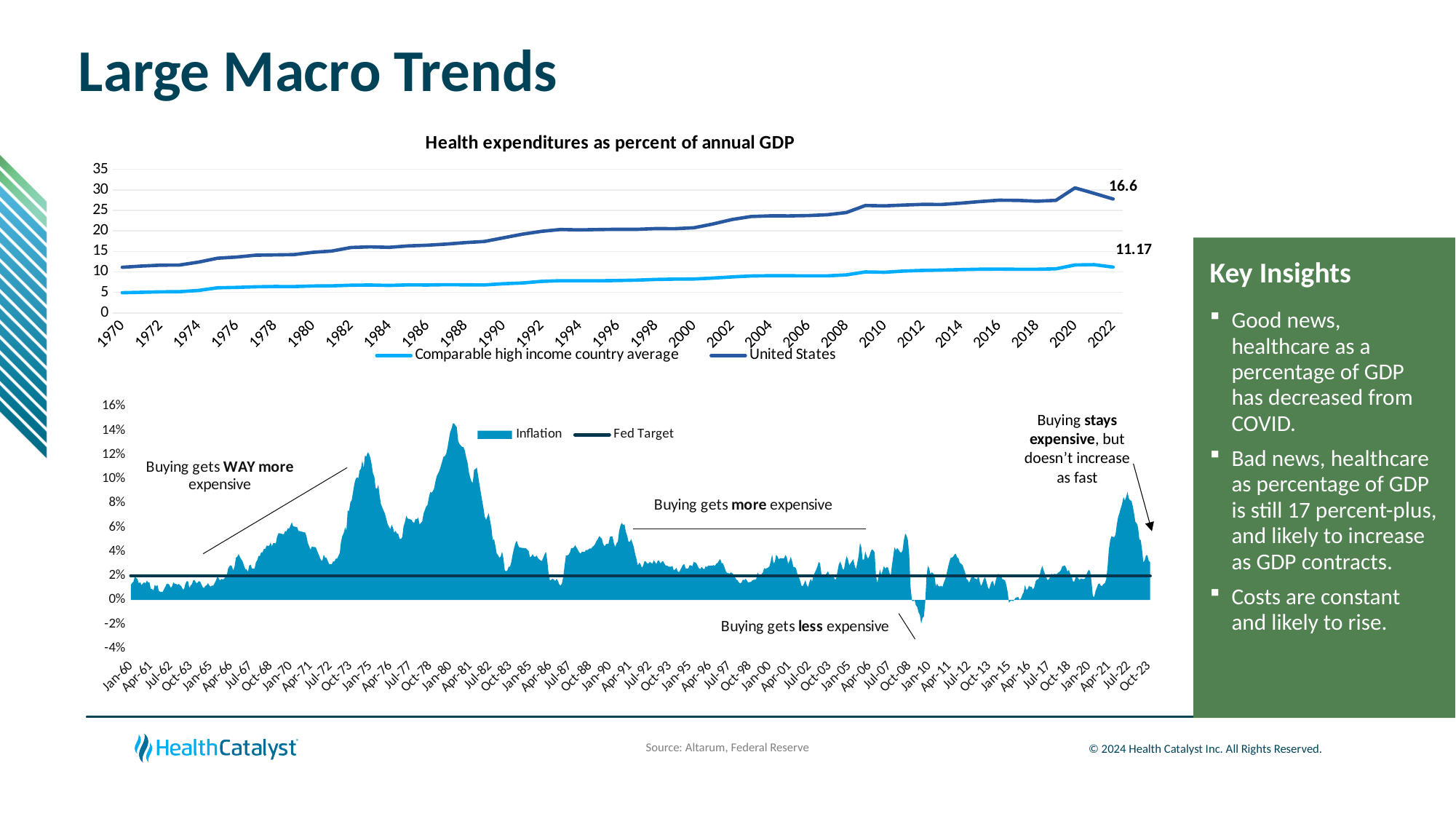
In the top chart 'Health expenditures as percent of annual GDP', what is the difference between the final labeled values for the United States and the comparable high income country average? 5.43 In the top chart 'Health expenditures as percent of annual GDP', what is the final labeled value for the comparable high income country average? 11.17 In the top chart 'Health expenditures as percent of annual GDP', what is the final labeled value for the United States? 16.6 In the top chart 'Health expenditures as percent of annual GDP', do the United States values generally rise or fall from 1970 to 2022? Rise In the top chart 'Health expenditures as percent of annual GDP', how many series does the legend list? 2 What kind of chart is the top chart 'Health expenditures as percent of annual GDP'? Line chart In the bottom inflation chart, what are the two legend entries? Inflation and Fed Target In the bottom inflation chart, what value does the Fed Target line sit at? 2% In the top chart 'Health expenditures as percent of annual GDP', which series is higher at the end of the period, the United States or the comparable high income country average? United States In the top chart 'Health expenditures as percent of annual GDP', is the United States value in 1970 greater or less than 15? less In the bottom inflation chart, how many series does the legend list? 2 In the bottom inflation chart, is the peak inflation value around 1980 greater or less than 12%? greater